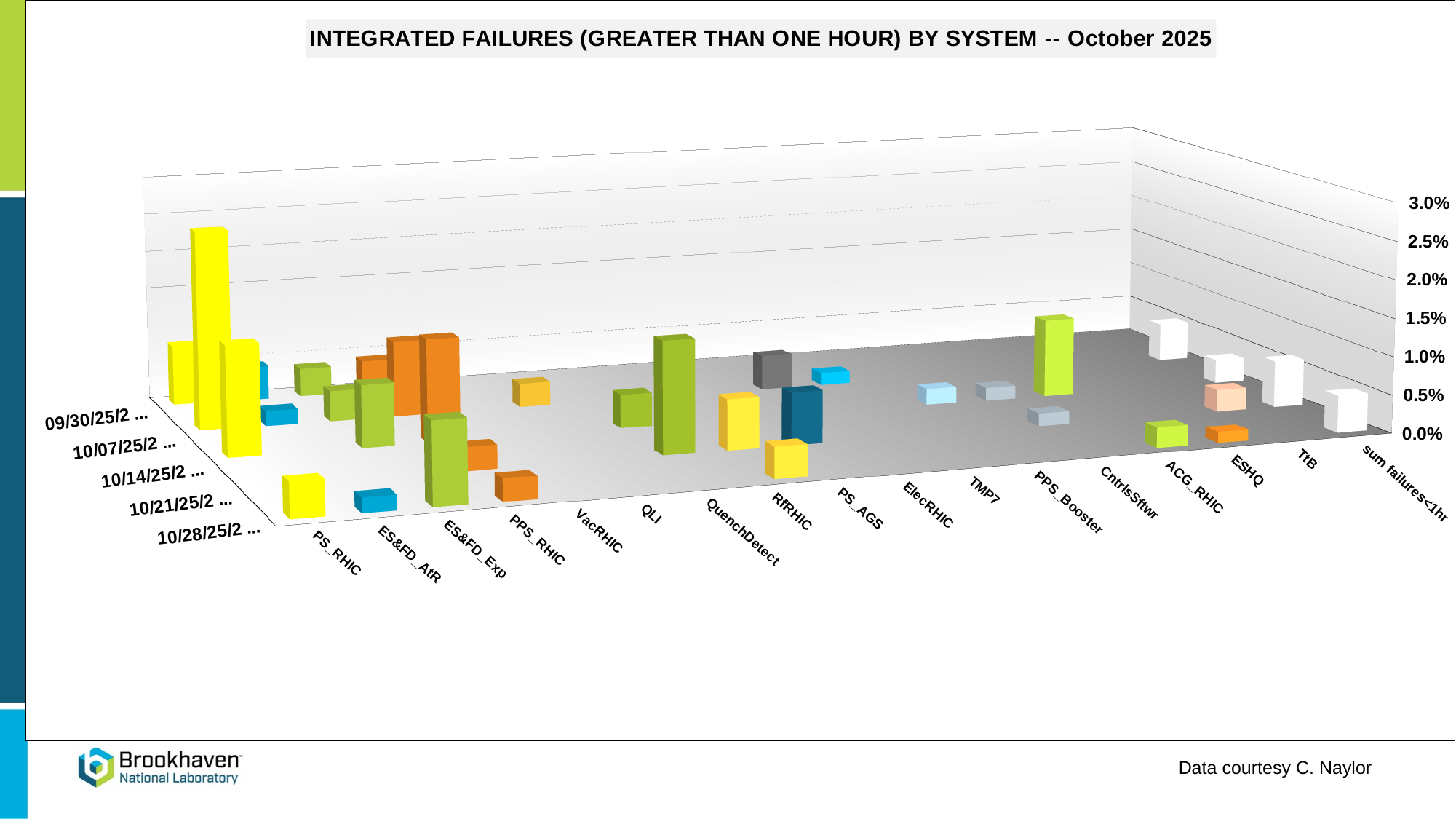
Is the tallest bar for TMP7 greater or less than 1.0%? less Is the tallest bar for PS_RHIC greater or less than 1.5%? greater What is the title of the chart? INTEGRATED FAILURES (GREATER THAN ONE HOUR) BY SYSTEM -- October 2025 How many weekly date series are shown along the depth axis of the chart? 5 Which system has the tallest bar in the chart? PS_RHIC What is the highest value shown on the vertical axis of the chart? 3.0% What kind of chart is shown on the slide? 3D bar chart Which has a taller bar in the chart, QLI or TMP7? QLI How many system categories are shown along the horizontal axis of the chart? 17 Which has a taller bar in the chart, PS_RHIC or ElecRHIC? PS_RHIC Is the tallest bar for ElecRHIC greater or less than 1.0%? less What is the first date label shown on the depth axis of the chart? 09/30/25/2 ...